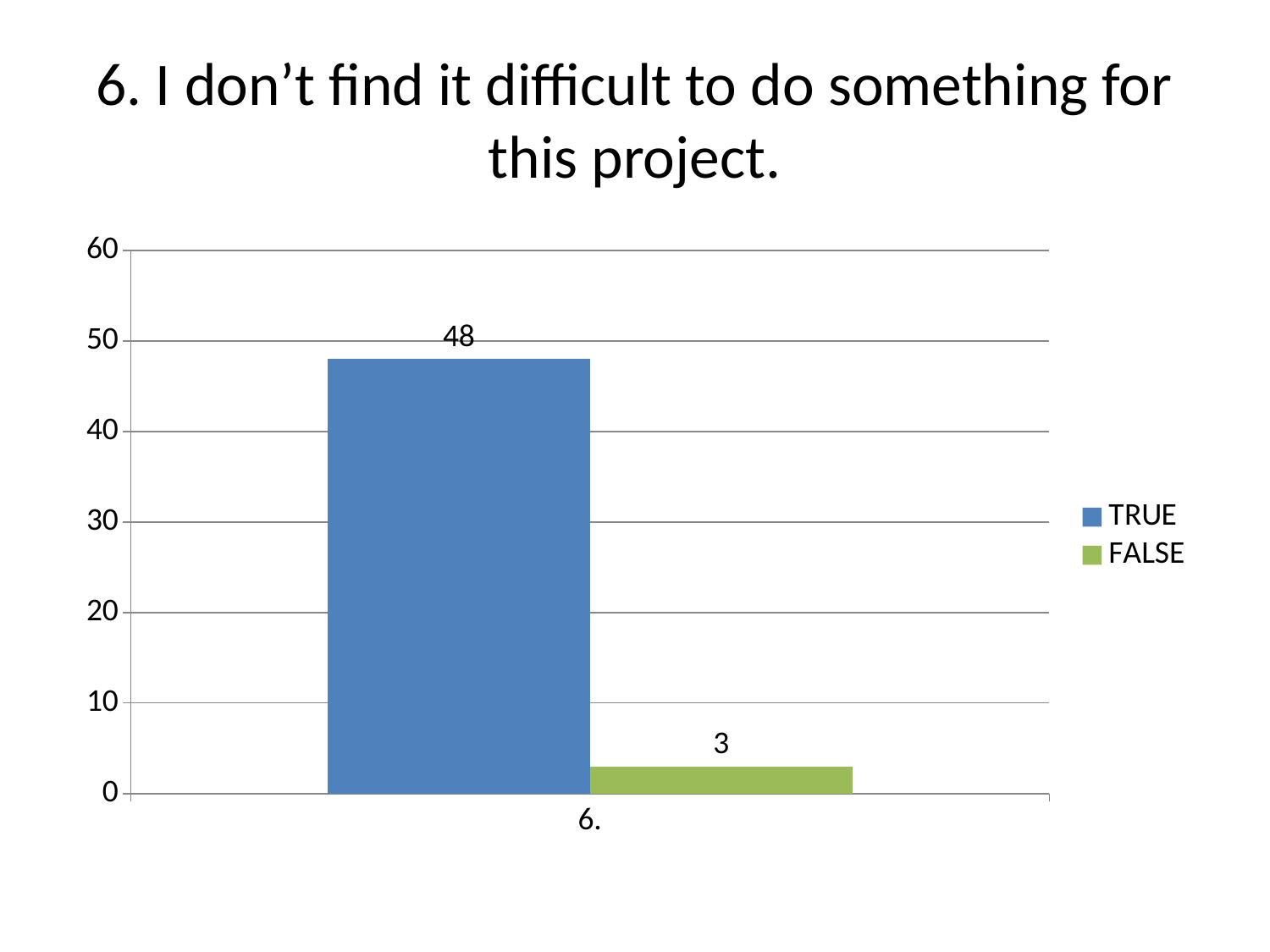
What is the value for FALSE? 3 Is the value for FALSE greater or less than 10? less Which series has the lowest value? FALSE What is the category label shown on the x axis? 6. What kind of chart is shown on the slide? bar chart Is the value for TRUE greater or less than 40? greater What is the value for TRUE? 48 What colour is the bar for FALSE? green What is the total of the TRUE and FALSE values? 51 What is the difference between the TRUE and FALSE values? 45 How many series does the legend list? 2 Which series has the higher value, TRUE or FALSE? TRUE